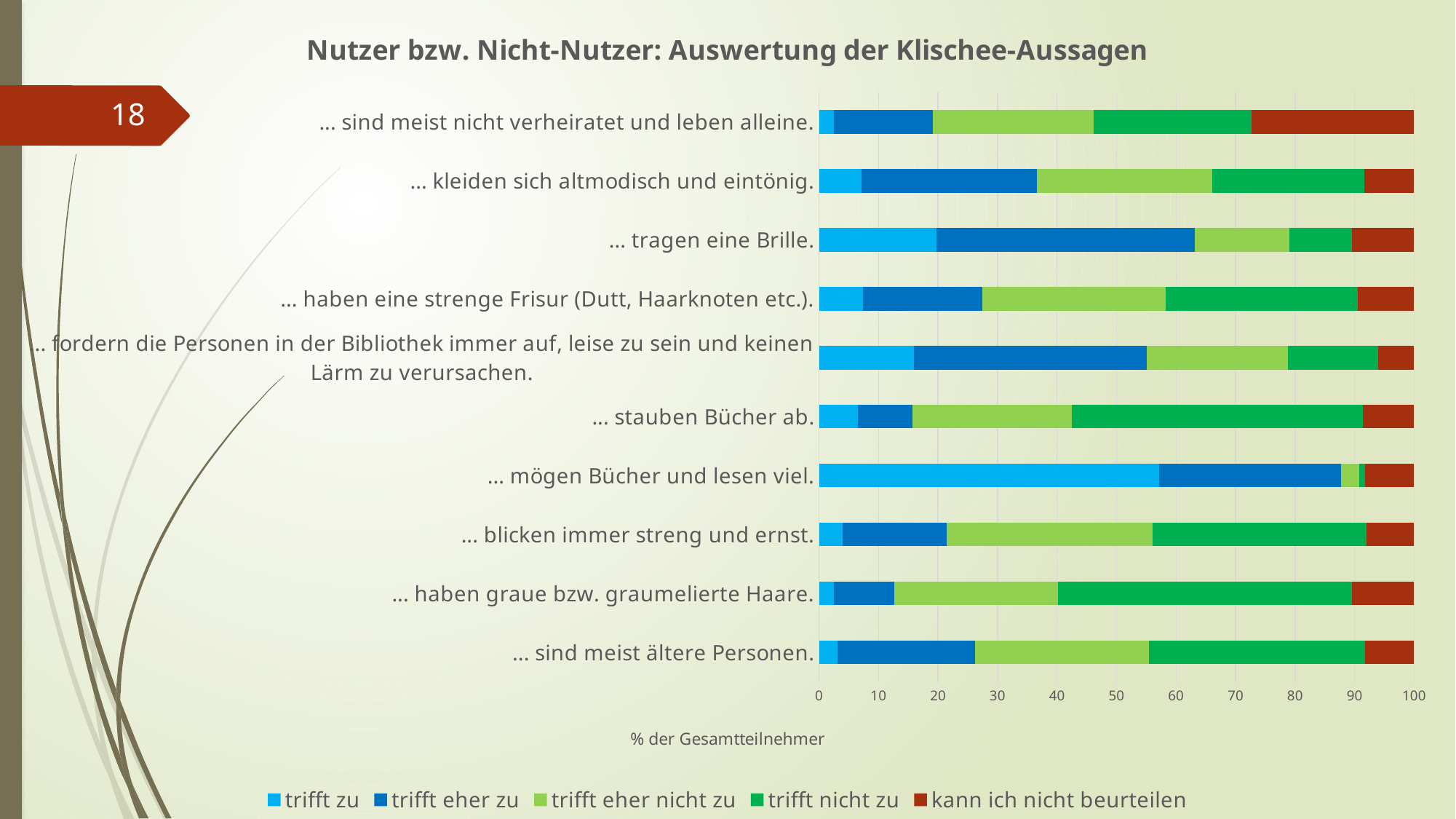
Which has the larger "trifft zu" segment: "... tragen eine Brille." or "... stauben Bücher ab."? ... tragen eine Brille. Which statement has the smallest "trifft eher nicht zu" segment? ... mögen Bücher und lesen viel. Is the "trifft zu" value for "... fordern die Personen in der Bibliothek immer auf, leise zu sein und keinen Lärm zu verursachen." greater or less than 10? greater What is the label on the horizontal axis of the chart? % der Gesamtteilnehmer Which statement has the largest "kann ich nicht beurteilen" segment? ... sind meist nicht verheiratet und leben alleine. Which statement has the largest "trifft zu" segment? ... mögen Bücher und lesen viel. What is the title of the chart? Nutzer bzw. Nicht-Nutzer: Auswertung der Klischee-Aussagen Is the "trifft zu" value for "... tragen eine Brille." greater or less than 30? less How many statements (categories) are plotted in the chart? 10 Is the "trifft zu" value for "... mögen Bücher und lesen viel." greater or less than 50? greater How many series does the legend list? 5 What kind of chart is shown on the slide? stacked bar chart